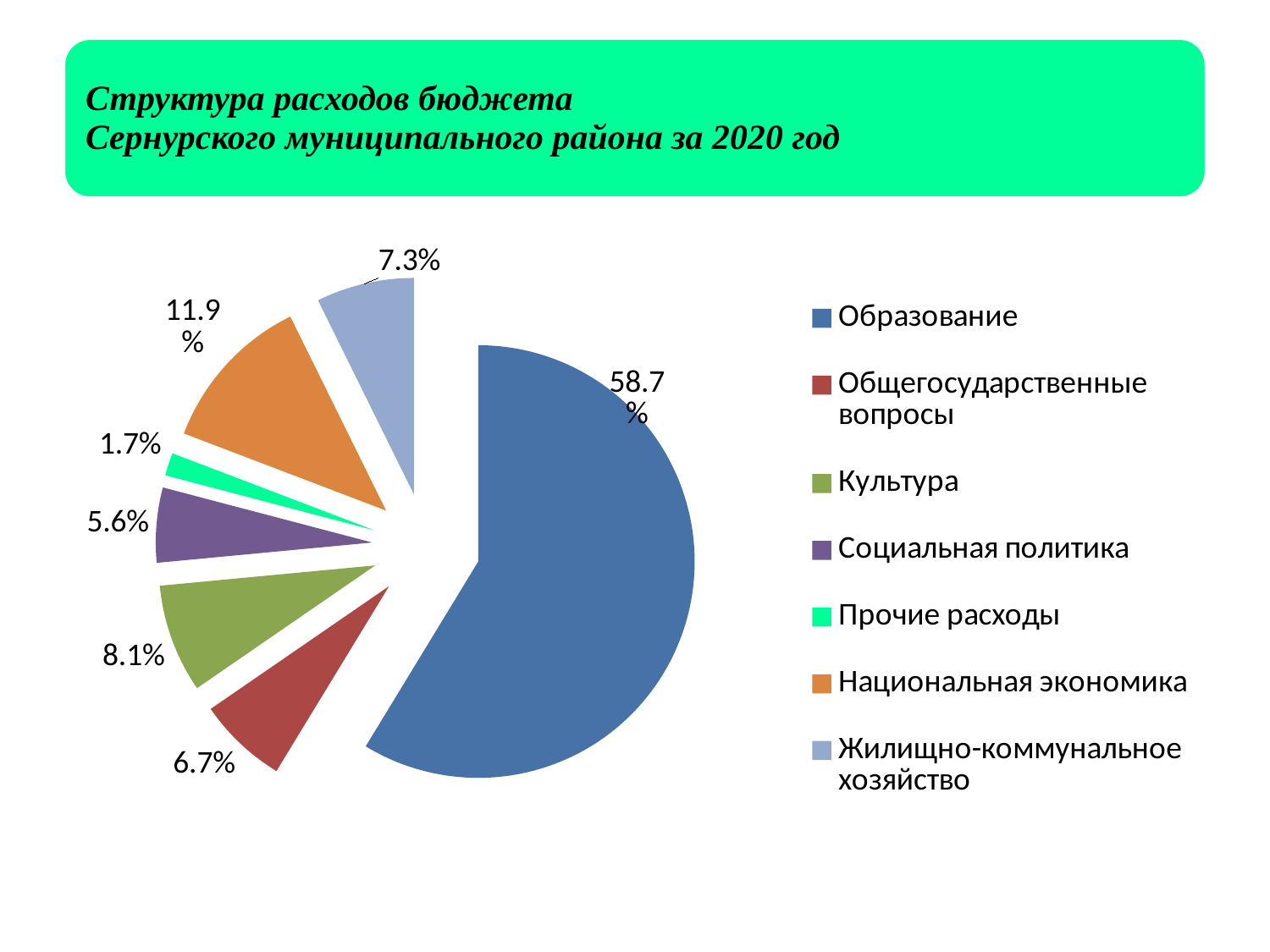
What is the difference between the shares for Национальная экономика and Социальная политика? 6.3% What share of budget expenditure goes to Жилищно-коммунальное хозяйство? 7.3% What is the title of the slide? Структура расходов бюджета Сернурского муниципального района за 2020 год What share of budget expenditure goes to Культура? 8.1% What share of budget expenditure goes to Прочие расходы? 1.7% Which category has the smallest share of the pie? Прочие расходы Which is larger: the share for Культура or the share for Общегосударственные вопросы? Культура What share of budget expenditure goes to Национальная экономика? 11.9% What kind of chart is shown on the slide? pie chart How many categories does the pie chart show? 7 What share of budget expenditure goes to Образование? 58.7% Which category has the largest share of the pie? Образование